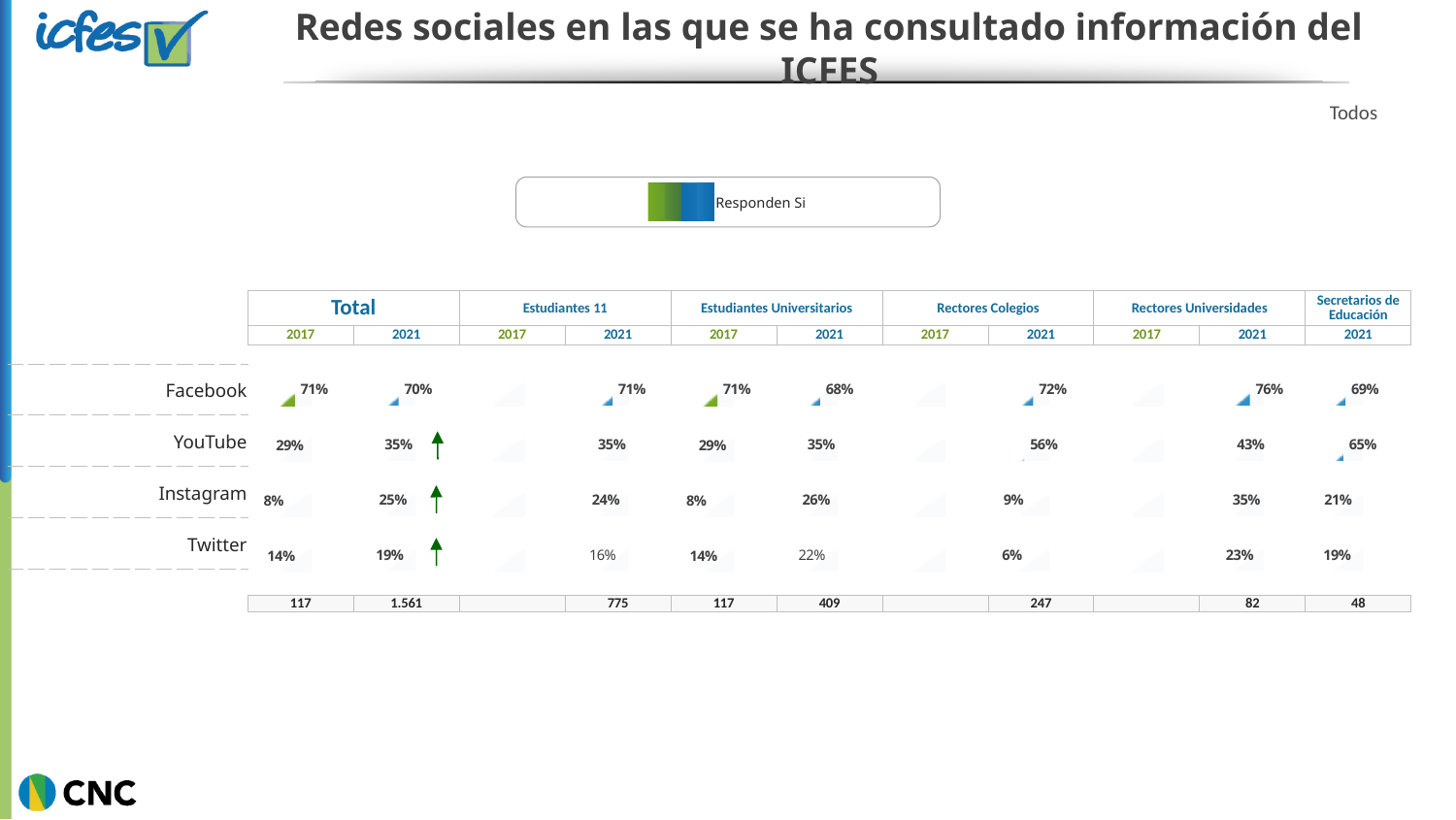
What is the Total 2017 value for Instagram? 8% What is the difference between the Total 2021 and Total 2017 values for YouTube? 6% How many social networks are listed in the chart? 4 Which is larger for Instagram in 2021: Rectores Universidades or Rectores Colegios? Rectores Universidades Did the Total value for Twitter rise or fall from 2017 to 2021? rise What is the Total 2021 value for Facebook? 70% What is the base (number of respondents) shown for Total 2021? 1.561 Which social network has the lowest Total 2017 value? Instagram Which social network has the highest Total 2021 value? Facebook What is the 2021 value for Twitter among Rectores Colegios? 6% What is the 2021 value for YouTube among Secretarios de Educación? 65% What label appears in the legend box above the chart? Responden Si